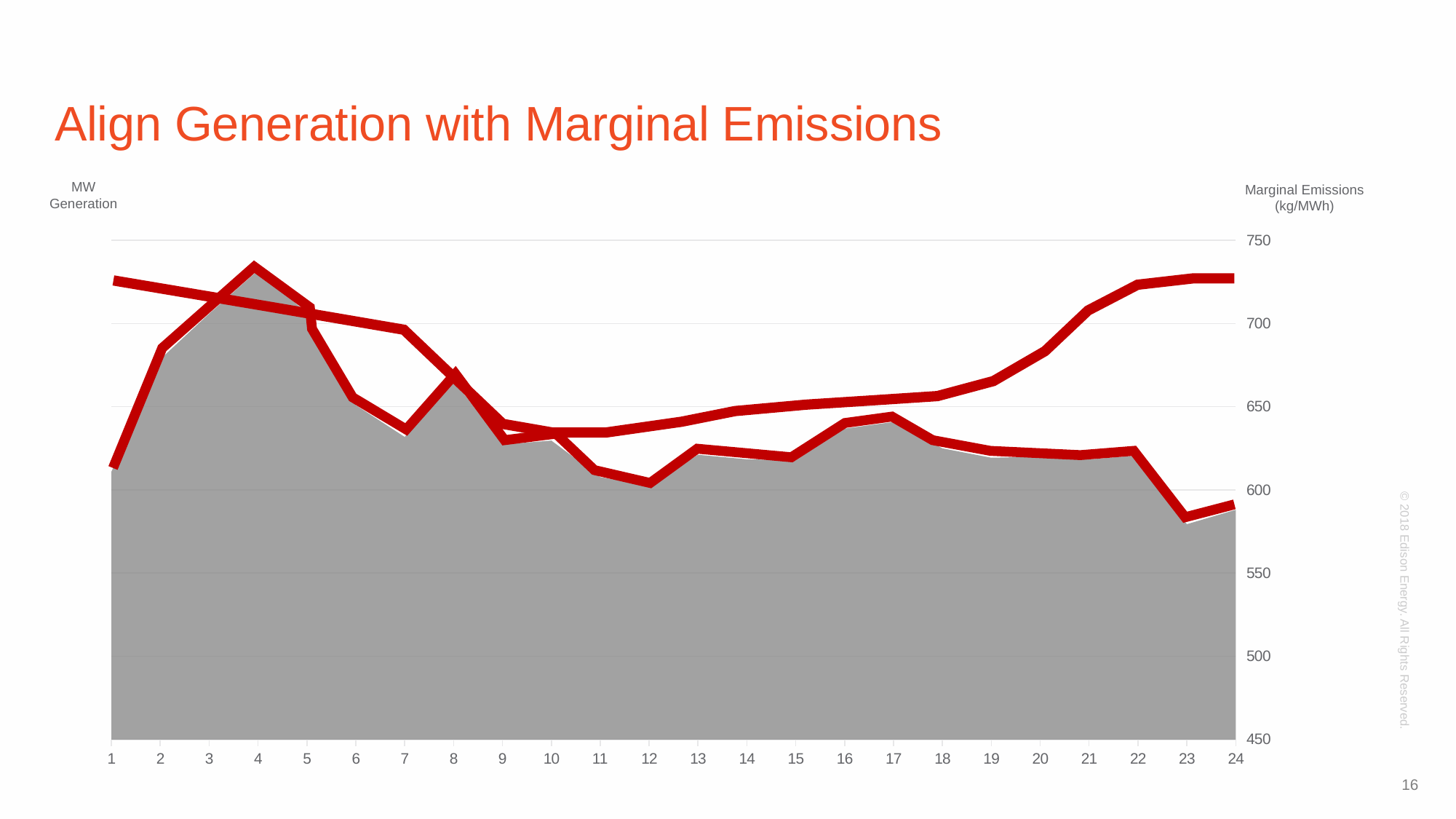
Does the marginal emissions line rise or fall from hour 12 to hour 24? rise Is the marginal emissions value at hour 1 greater or less than 700 kg/MWh? greater How many points are plotted along the x axis? 24 Is the marginal emissions value at hour 11 greater or less than 650 kg/MWh? less What is the lowest value shown on the right-hand axis? 450 Is the marginal emissions value at hour 20 greater or less than 650 kg/MWh? greater What is the label and unit of the right-hand axis? Marginal Emissions (kg/MWh) Does the marginal emissions line rise or fall from hour 1 to hour 11? fall What is the title of the chart on the slide? Align Generation with Marginal Emissions What kind of chart is the gray shaded MW Generation series? area chart